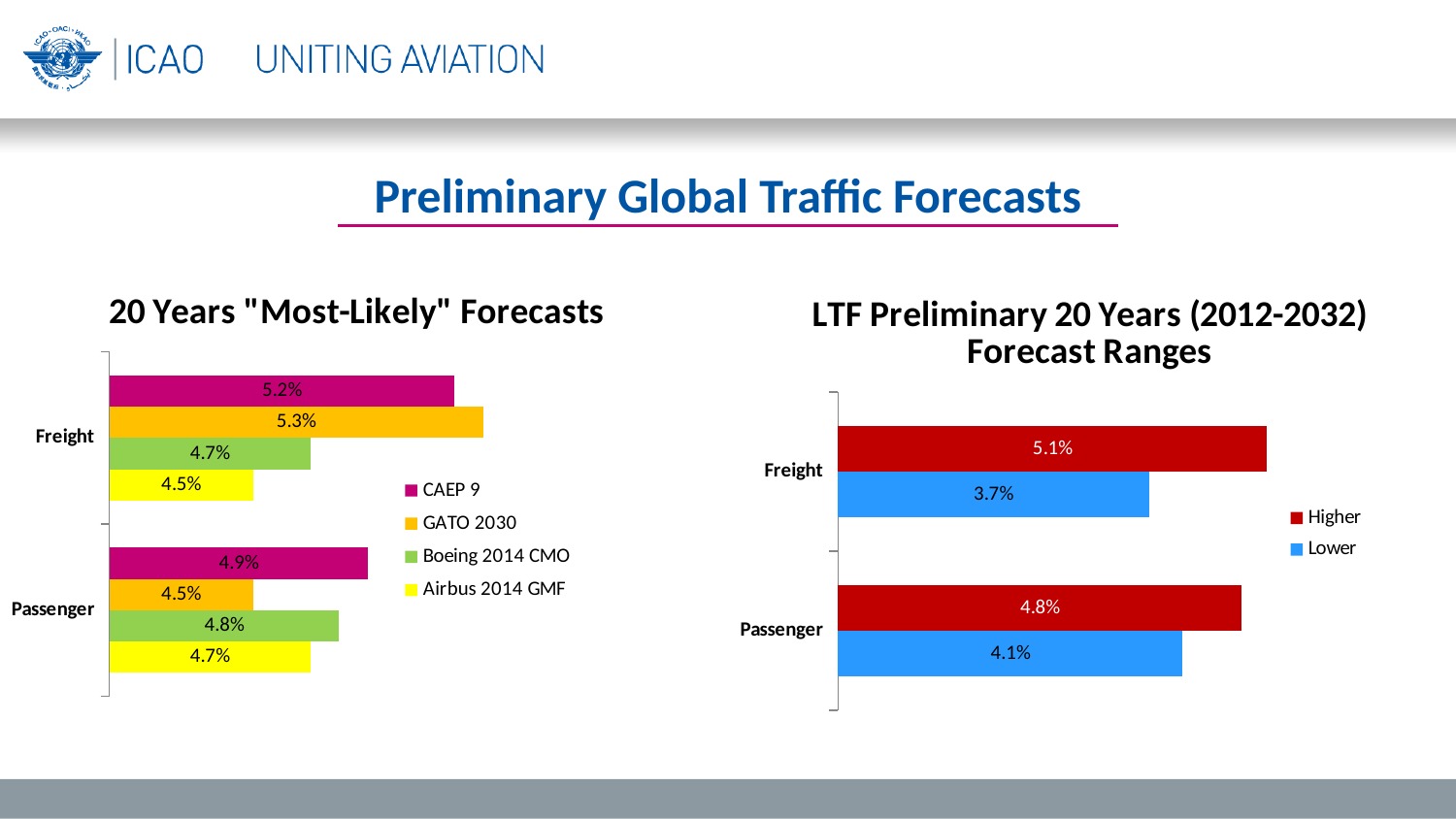
In the "20 Years "Most-Likely" Forecasts" chart, what is the difference between the CAEP 9 values for Freight and Passenger? 0.3% In the "20 Years "Most-Likely" Forecasts" chart, which series has the lowest value for Passenger? GATO 2030 In the "20 Years "Most-Likely" Forecasts" chart, which series has the highest value for Freight? GATO 2030 In the "LTF Preliminary 20 Years (2012-2032) Forecast Ranges" chart, what is the Lower value for Freight? 3.7% In the "20 Years "Most-Likely" Forecasts" chart, which colour represents Boeing 2014 CMO? Green In the "20 Years "Most-Likely" Forecasts" chart, how many series does the legend list? 4 What type of chart is the "LTF Preliminary 20 Years (2012-2032) Forecast Ranges" chart? Bar chart In the "20 Years "Most-Likely" Forecasts" chart, what is the Airbus 2014 GMF value for Passenger? 4.7% In the "LTF Preliminary 20 Years (2012-2032) Forecast Ranges" chart, which is larger: the Lower value for Freight or the Lower value for Passenger? Passenger In the "LTF Preliminary 20 Years (2012-2032) Forecast Ranges" chart, what is the Higher value for Passenger? 4.8% In the "LTF Preliminary 20 Years (2012-2032) Forecast Ranges" chart, what is the difference between the Higher and Lower values for Freight? 1.4% In the "20 Years "Most-Likely" Forecasts" chart, what is the GATO 2030 value for Freight? 5.3%